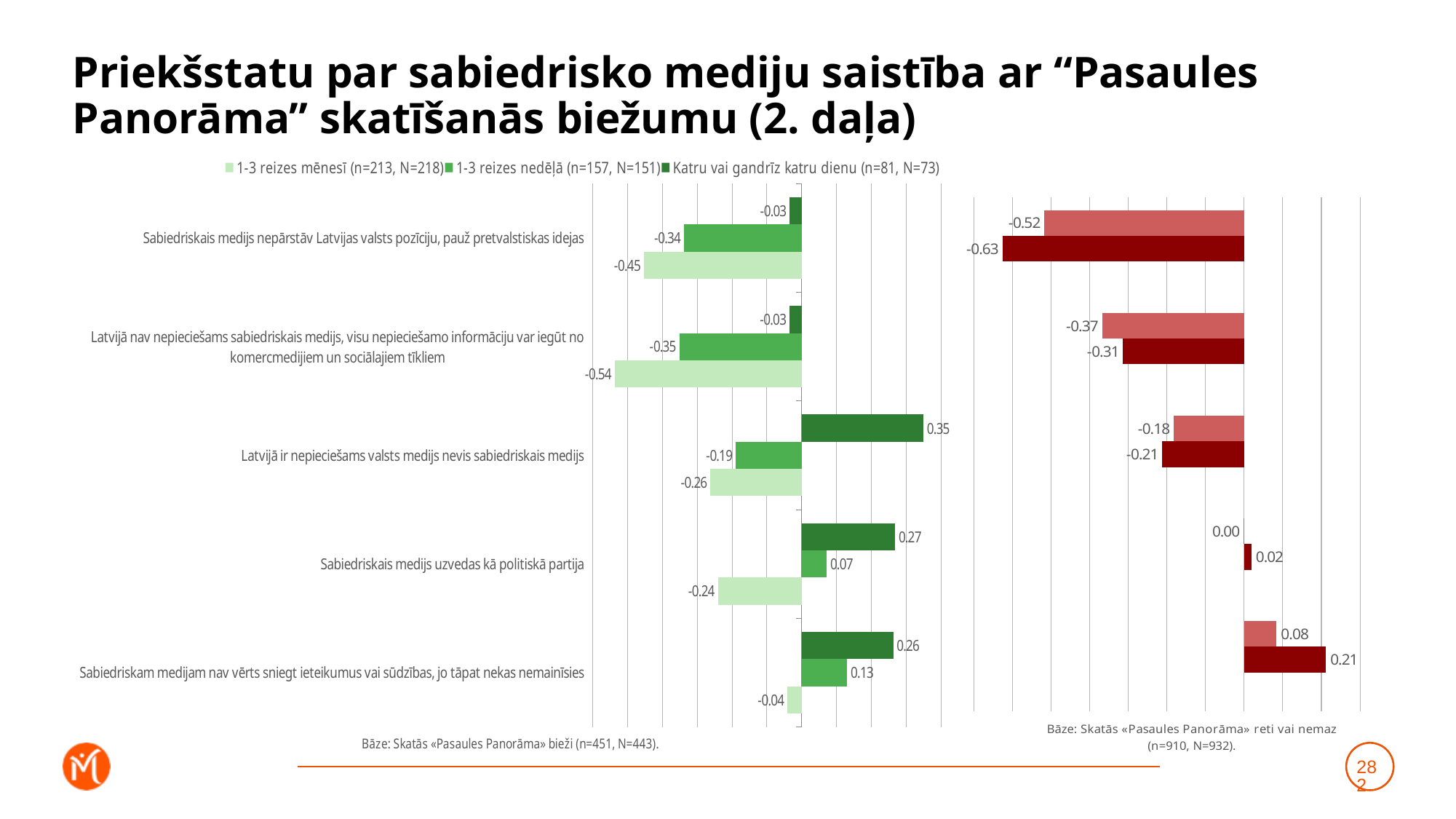
How many series does the legend of the left (green) chart list? 3 How many statement categories are shown on the left (green) chart? 5 On the right (red) chart, what is the value of the darker red bar for 'Sabiedriskais medijs nepārstāv Latvijas valsts pozīciju, pauž pretvalstiskas idejas'? -0.63 On the right (red) chart, for 'Latvijā nav nepieciešams sabiedriskais medijs...', which bar has the larger (less negative) value: the lighter red bar (-0.37) or the darker red bar (-0.31)? The darker red bar (-0.31) On the left (green) chart, which statement has the highest value for the 'Katru vai gandrīz katru dienu' series? Latvijā ir nepieciešams valsts medijs nevis sabiedriskais medijs On the left (green) chart, what is the difference between the 'Katru vai gandrīz katru dienu' value (0.27) and the '1-3 reizes nedēļā' value (0.07) for 'Sabiedriskais medijs uzvedas kā politiskā partija'? 0.20 What base (Bāze) is stated below the right (red) chart? Skatās «Pasaules Panorāma» reti vai nemaz (n=910, N=932) On the left (green) chart, what is the value for 'Katru vai gandrīz katru dienu' for 'Latvijā ir nepieciešams valsts medijs nevis sabiedriskais medijs'? 0.35 On the left (green) chart, what is the value for '1-3 reizes mēnesī' for 'Latvijā nav nepieciešams sabiedriskais medijs, visu nepieciešamo informāciju var iegūt no komercmedijiem un sociālajiem tīkliem'? -0.54 On the left (green) chart, what is the value for '1-3 reizes nedēļā' for 'Sabiedriskam medijam nav vērts sniegt ieteikumus vai sūdzības, jo tāpat nekas nemainīsies'? 0.13 On the right (red) chart, what is the value of the lighter red bar for 'Sabiedriskam medijam nav vērts sniegt ieteikumus vai sūdzības, jo tāpat nekas nemainīsies'? 0.08 What kind of chart is the left (green) chart? Bar chart